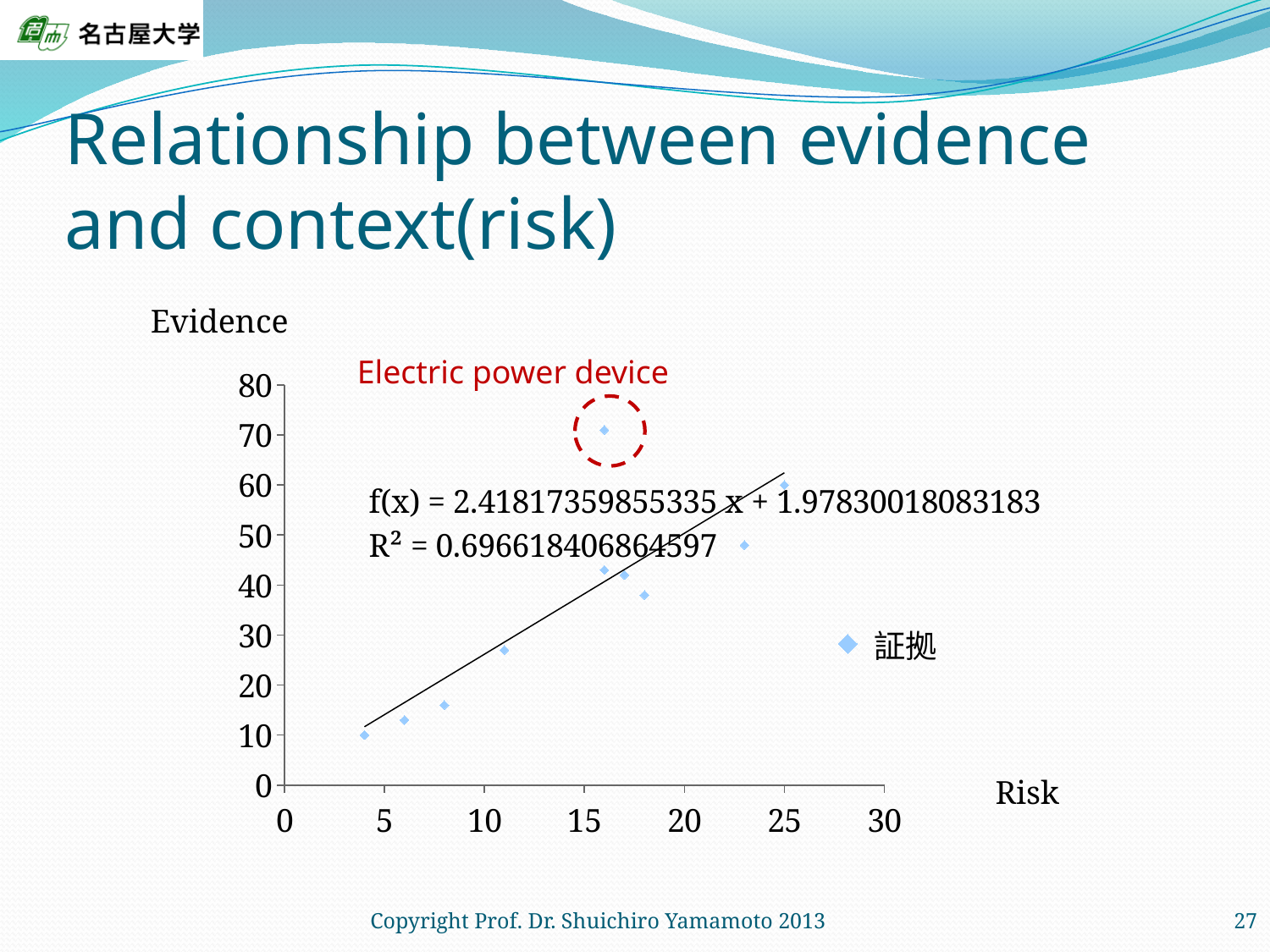
What R² value is printed for the trendline? R² = 0.696618406864597 What kind of chart is shown on the slide? scatter chart What label is given to the circled data point? Electric power device Is the Evidence value of the circled 'Electric power device' point greater or less than 60? greater How many series does the legend list? 1 What is the highest value shown on the Evidence (y) axis? 80 What is the trendline equation printed on the chart? f(x) = 2.41817359855335 x + 1.97830018083183 Is the Risk value of the circled 'Electric power device' point greater or less than 20? less How many data points are plotted on the chart? 10 What is the legend entry for the plotted series? 証拠 Do the Evidence values generally rise or fall as Risk increases along the x axis? rise Is the Evidence value of the point with the lowest Risk greater or less than 20? less